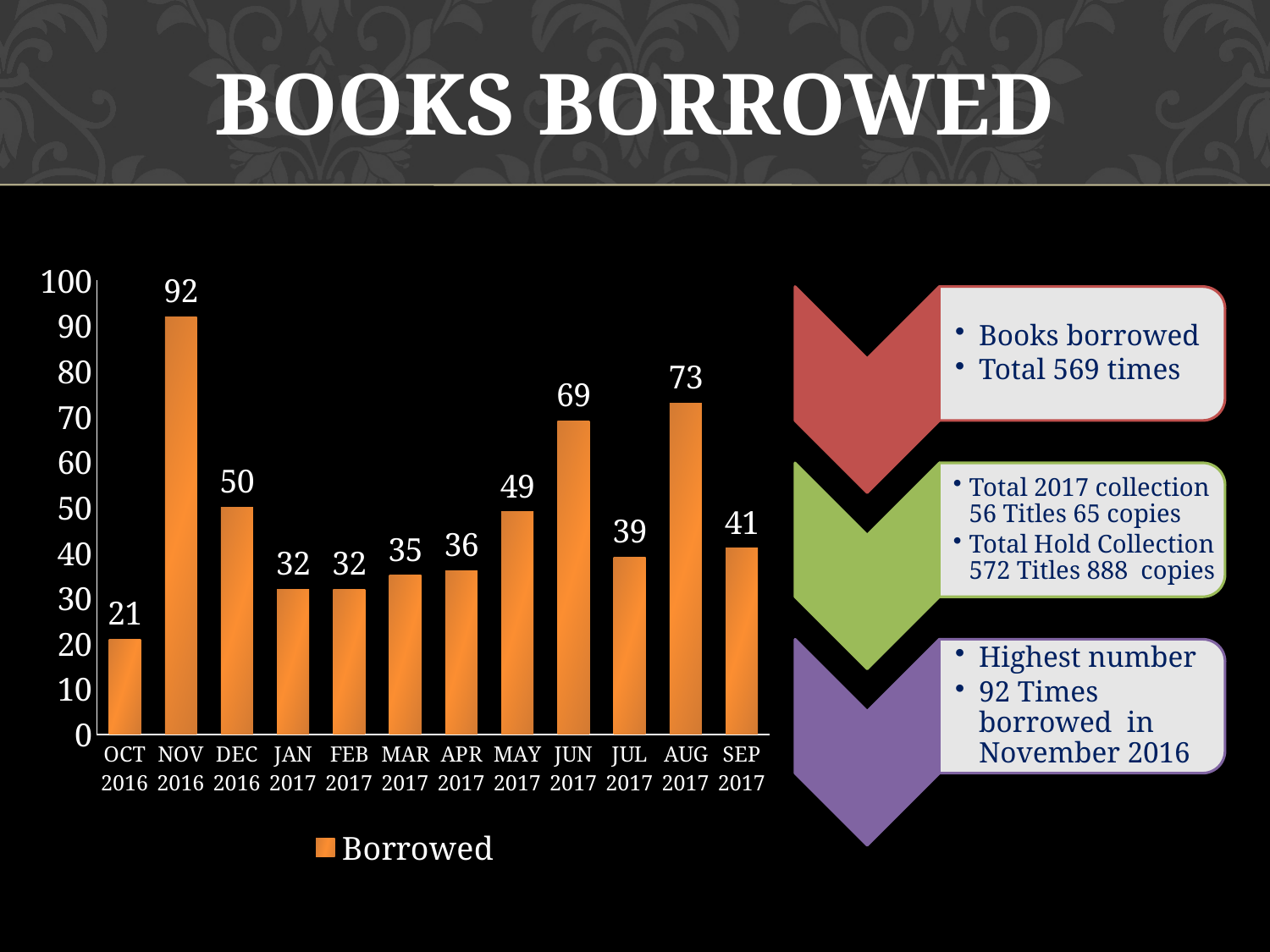
What is the value for OCT 2016? 21 What is the difference between the values for NOV 2016 and DEC 2016? 42 Which is larger, the value for JUN 2017 or the value for MAY 2017? JUN 2017 Which month has the lowest number of books borrowed? OCT 2016 What is the name of the series shown in the legend? Borrowed What kind of chart is shown on the slide? bar chart How many series does the legend list? 1 How many months are shown on the x axis? 12 What is the value for AUG 2017? 73 Which month has the highest number of books borrowed? NOV 2016 How many books were borrowed in NOV 2016? 92 What is the difference between the values for AUG 2017 and JUL 2017? 34